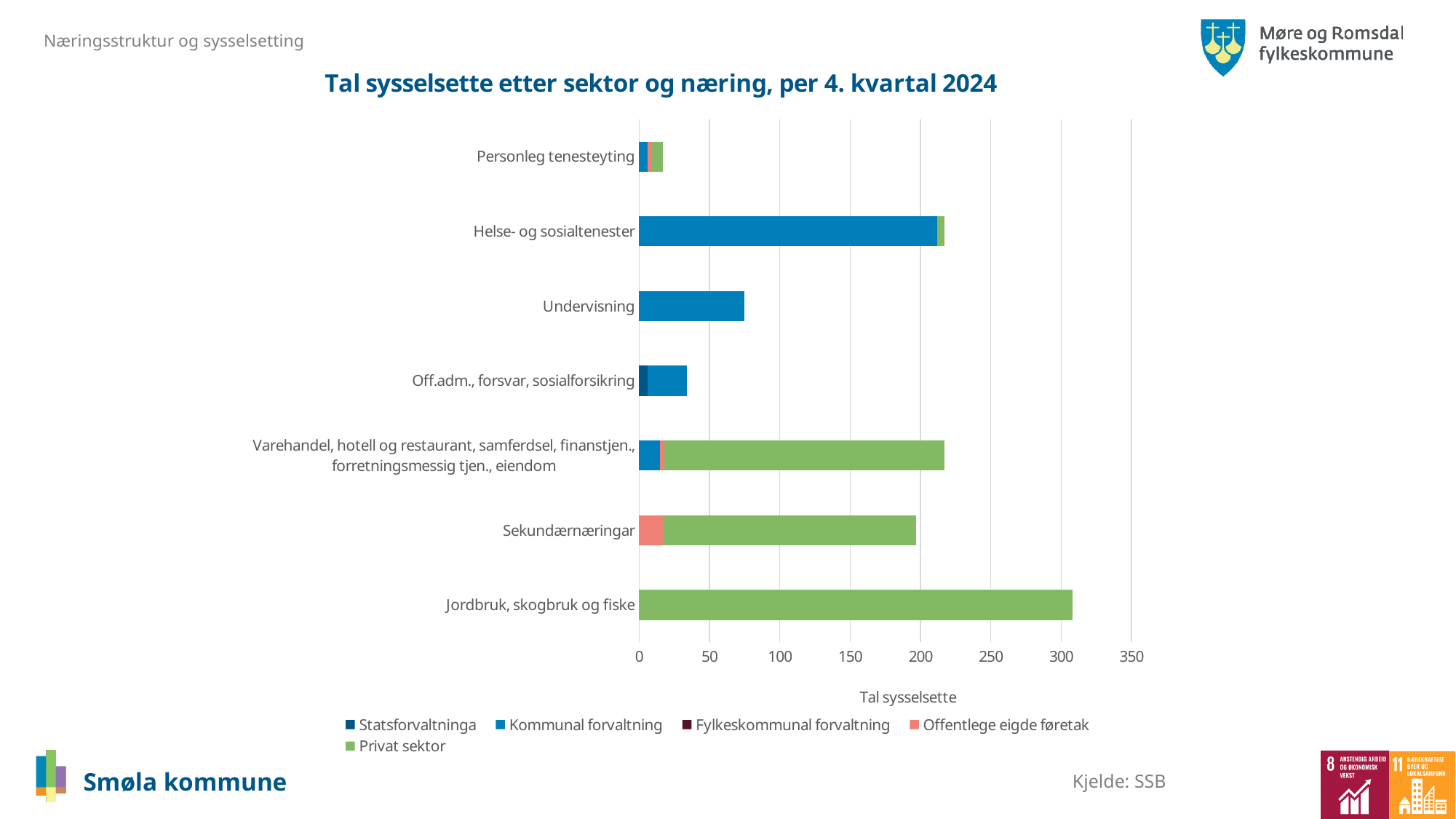
Which category has the lowest total number of sysselsette? Personleg tenesteyting What kind of chart is shown on the slide? Stacked bar chart Is the total value for Helse- og sosialtenester greater or less than 200? greater Which series is shown in green in the legend? Privat sektor What is the title of the chart? Tal sysselsette etter sektor og næring, per 4. kvartal 2024 Which has more sysselsette in total: Helse- og sosialtenester or Undervisning? Helse- og sosialtenester Is the value for Undervisning greater or less than 100? less Which category has the highest total number of sysselsette? Jordbruk, skogbruk og fiske How many categories (næringar) are shown on the y axis of the chart? 7 How many series does the legend list? 5 Is the total value for Jordbruk, skogbruk og fiske greater or less than 250? greater